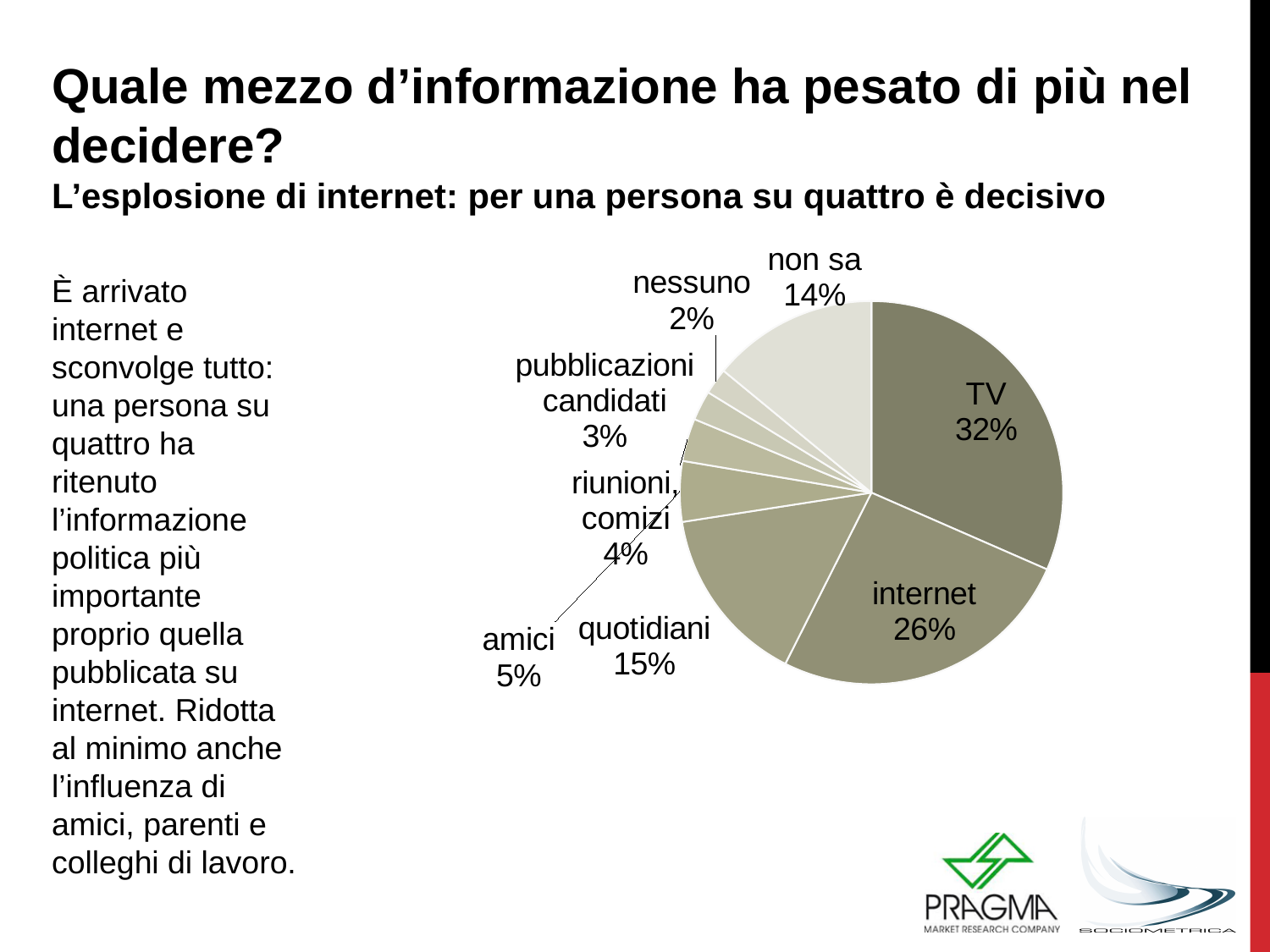
What is the value for non sa? 14% What is the difference between the TV and internet shares? 6% What is the value for quotidiani? 15% Which is larger, the share for quotidiani or the share for non sa? quotidiani Which category has the smallest slice of the pie? nessuno How many slices does the pie chart have? 8 What is the value for amici? 5% Which category has the largest slice of the pie? TV What is the combined share of riunioni, comizi and pubblicazioni candidati? 7% What share of the pie does TV have? 32% What kind of chart is shown on the slide? pie chart What is the value for internet? 26%